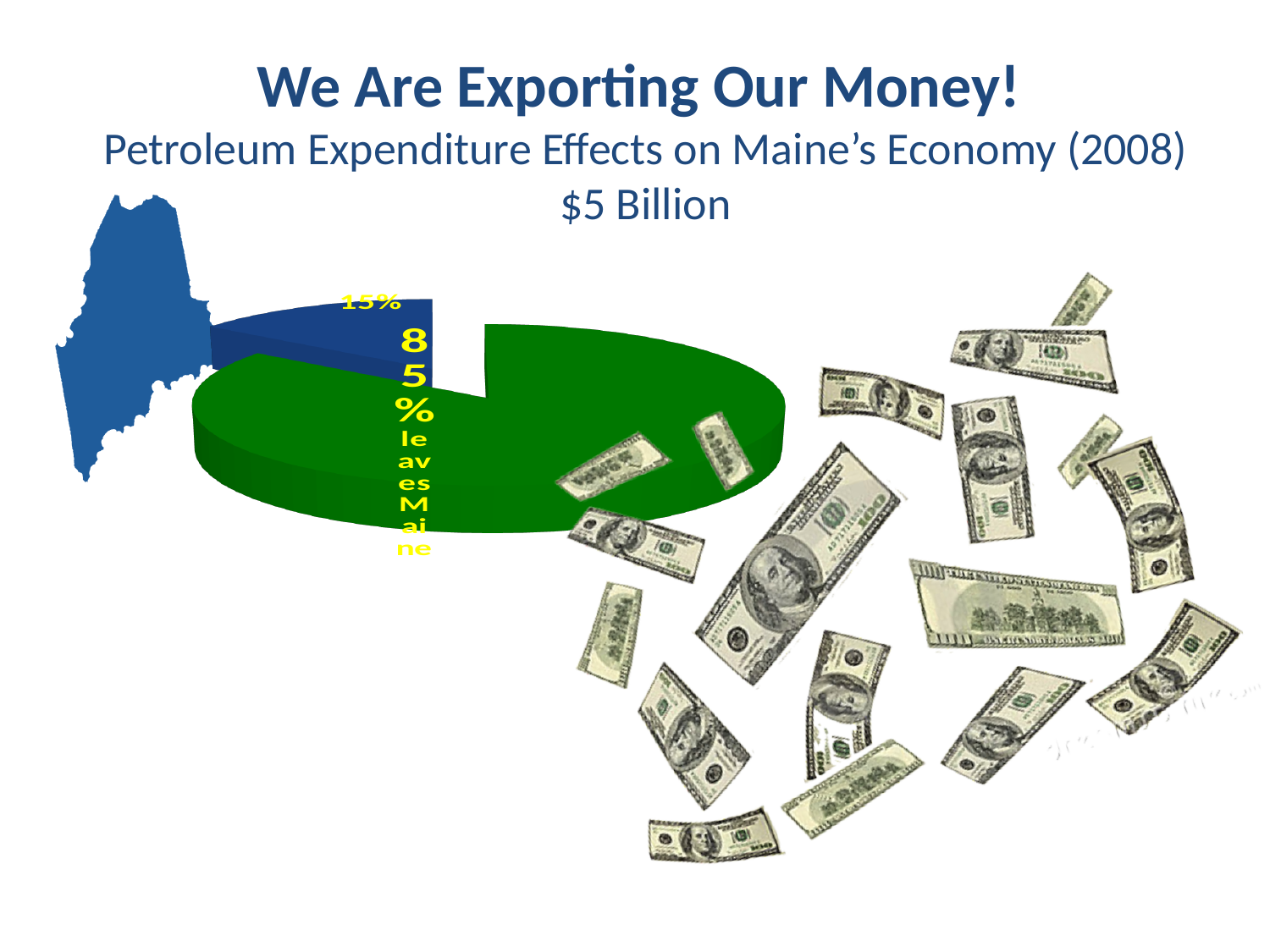
What share of the pie is labelled as leaving Maine? 85% Which slice of the pie chart is the smallest? the blue slice (15%) What year does the chart's subtitle refer to? 2008 Is the share of the blue slice greater or less than 50%? less How many slices does the pie chart have? 2 What is the difference in percentage points between the green slice and the blue slice? 70 percentage points What total dollar amount does the slide give for petroleum expenditure in Maine's economy in 2008? $5 Billion What percentage is shown on the blue slice of the pie chart? 15% What kind of chart is shown on the slide? pie chart What percentage is shown on the green slice of the pie chart? 85% Which slice of the pie chart is the largest? the green slice (85% leaves Maine) Which is larger, the green slice or the blue slice? the green slice